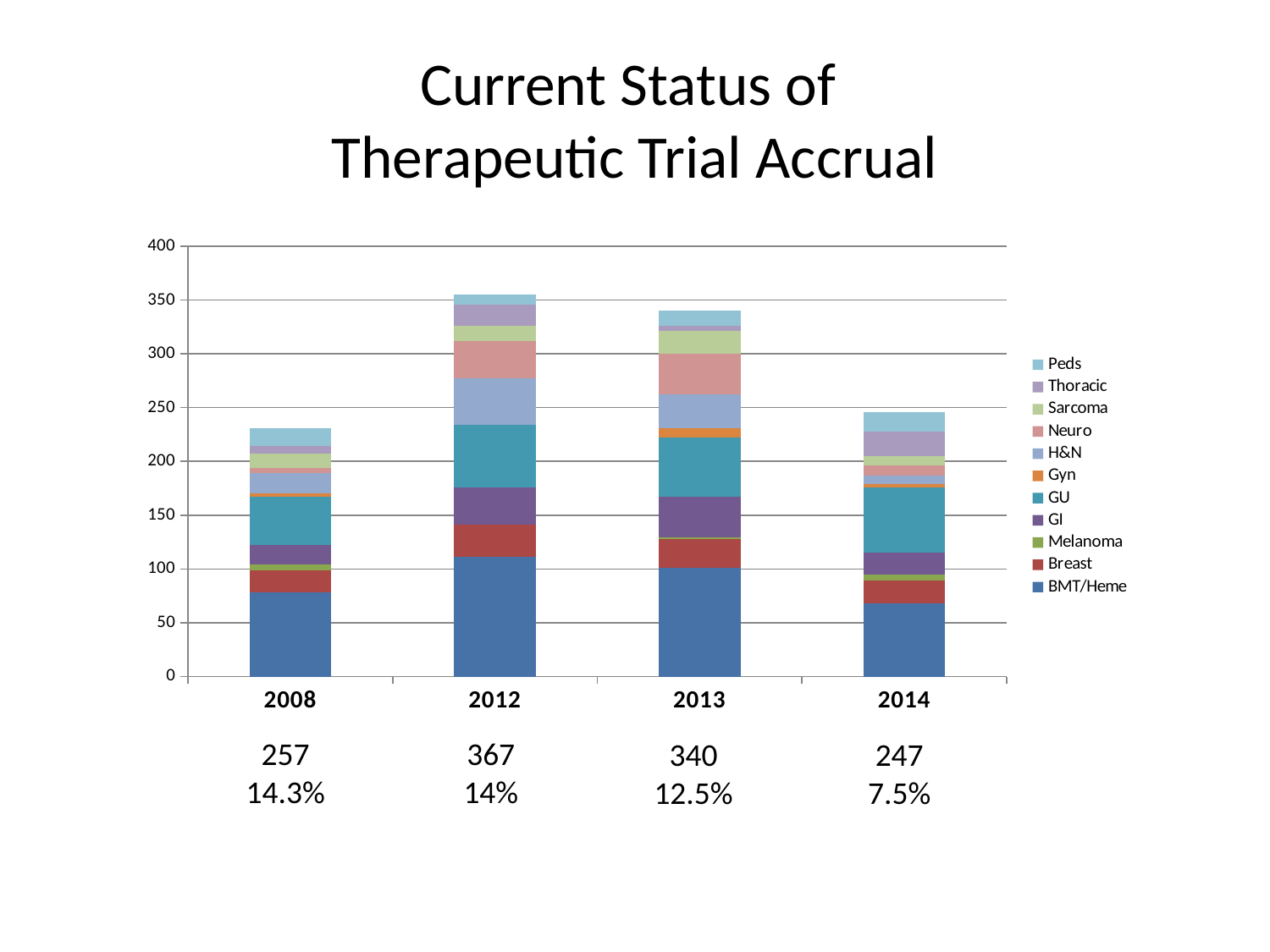
Is the total height of the 2013 bar greater or less than 300? greater Is the BMT/Heme segment for 2014 greater or less than 100? less Is the total height of the 2008 bar greater or less than 250? less How many series does the legend list? 11 Which stacked bar is taller, 2012 or 2013? 2012 Which year has the tallest stacked bar? 2012 Does the total bar height rise or fall from 2013 to 2014? fall What kind of chart is shown on the slide? stacked bar chart What percentage is printed below the 2014 bar? 7.5% Which series is listed at the bottom of the legend? BMT/Heme How many years (categories) are shown on the x axis? 4